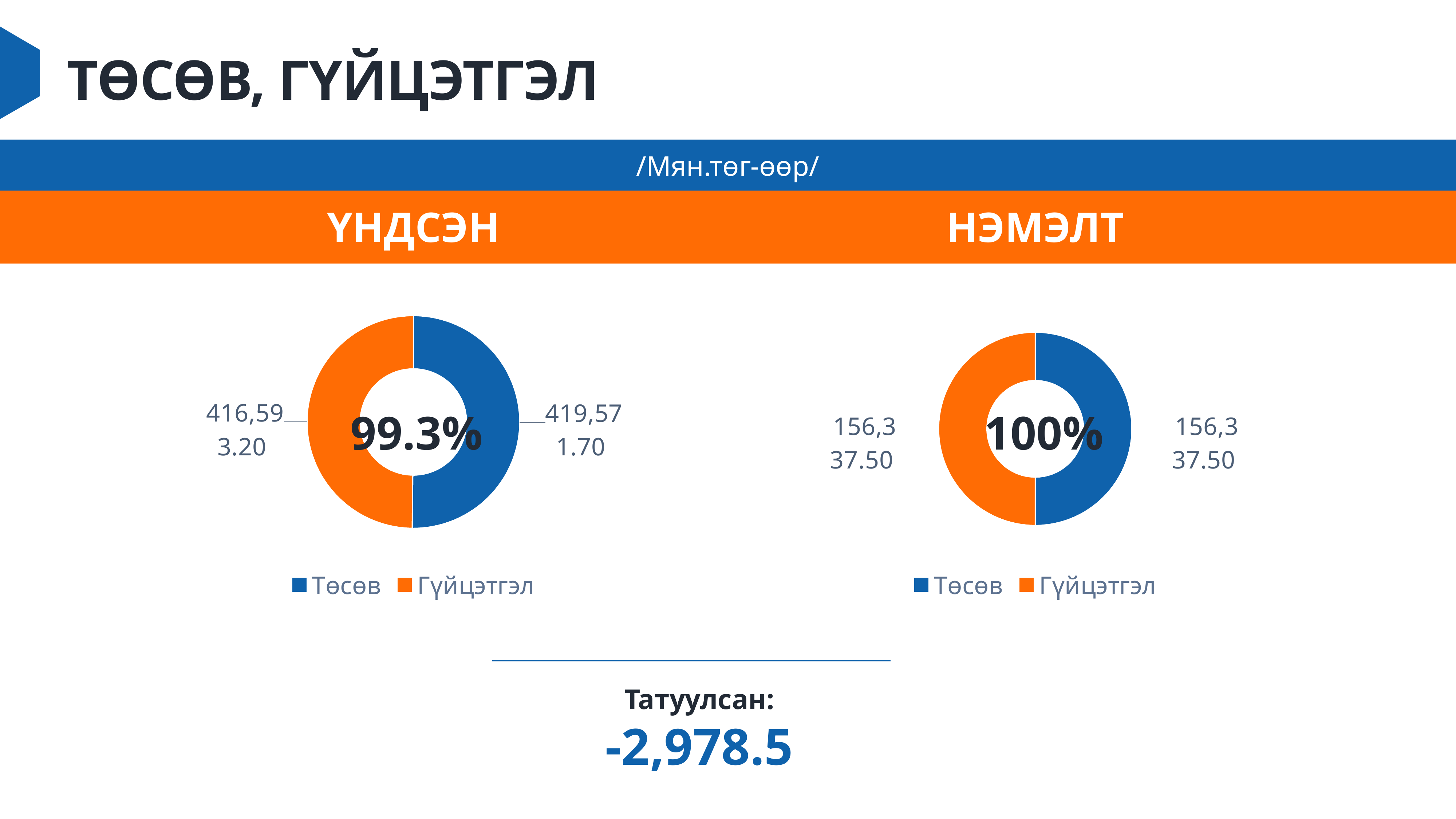
In the ҮНДСЭН chart on the left, what percentage is shown in the centre of the doughnut? 99.3% What kind of chart is the ҮНДСЭН chart on the left? Doughnut (pie) chart In the ҮНДСЭН chart on the left, what is the value for Гүйцэтгэл? 416,593.20 In the ҮНДСЭН chart on the left, what is the difference between Төсөв and Гүйцэтгэл? 2,978.50 In the ҮНДСЭН chart on the left, what is the value for Төсөв? 419,571.70 In the НЭМЭЛТ chart on the right, what is the value for Төсөв? 156,337.50 In the НЭМЭЛТ chart on the right, what percentage is shown in the centre of the doughnut? 100% In the ҮНДСЭН chart on the left, which colour represents Гүйцэтгэл? Orange In the ҮНДСЭН chart on the left, which is larger, Төсөв or Гүйцэтгэл? Төсөв How many entries does the legend of the НЭМЭЛТ chart on the right list? 2 How many slices does the ҮНДСЭН chart on the left have? 2 In the НЭМЭЛТ chart on the right, what is the value for Гүйцэтгэл? 156,337.50